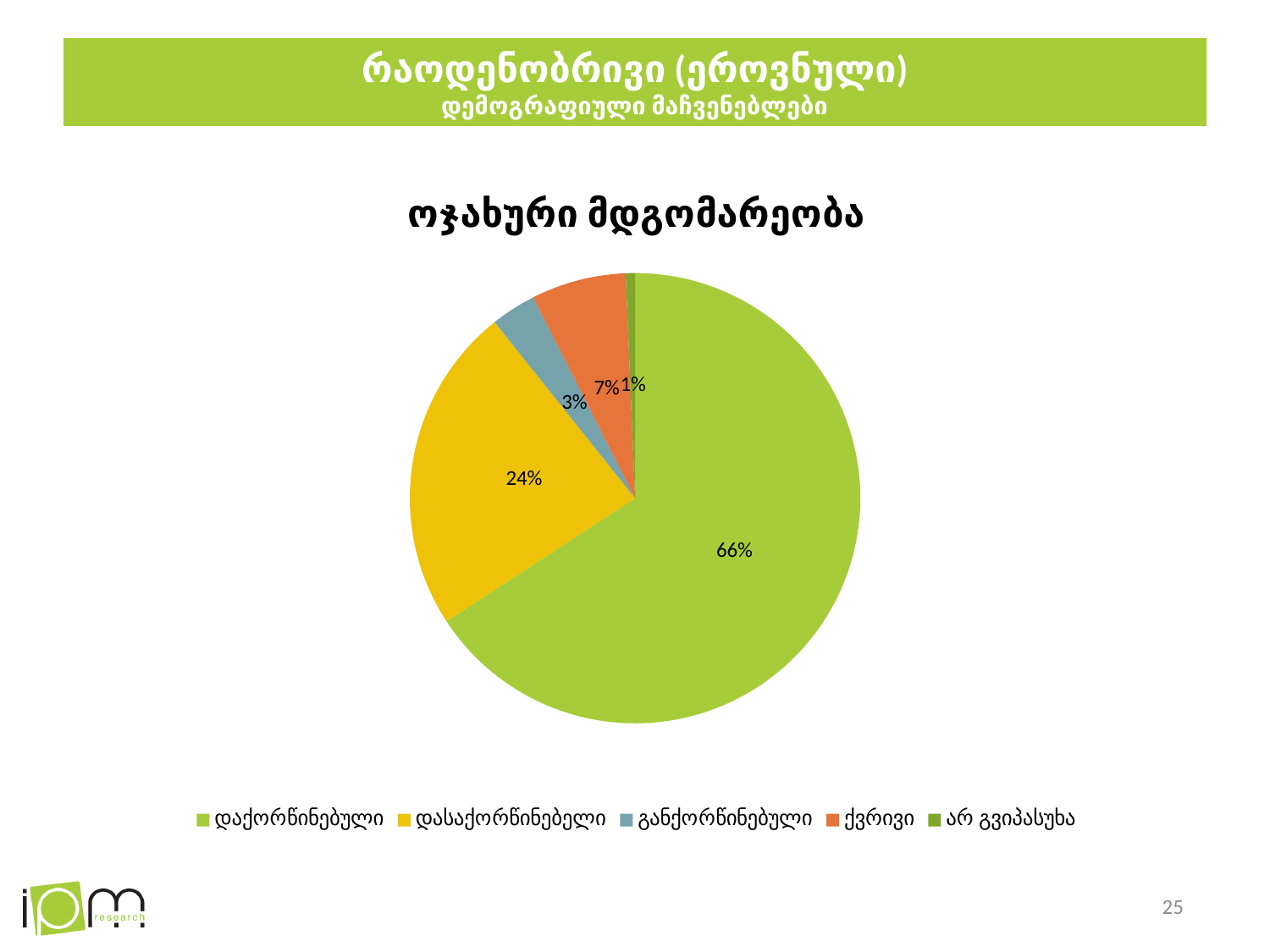
What is the difference in percentage points between დაქორწინებული and დასაქორწინებელი? 42 What percentage is shown for განქორწინებული? 3% What percentage of the pie chart is labelled დაქორწინებული? 66% What share does the დასაქორწინებელი slice have in the pie chart? 24% What is the title of the chart? ოჯახური მდგომარეობა What value is shown for ქვრივი in the pie chart? 7% Which category has the largest slice of the pie chart? დაქორწინებული Which category has the smallest slice of the pie chart? არ გვიპასუხა What type of chart is shown on the slide? pie chart Which is larger: the slice for ქვრივი or the slice for განქორწინებული? ქვრივი What percentage is shown for არ გვიპასუხა? 1% How many categories does the pie chart legend list? 5